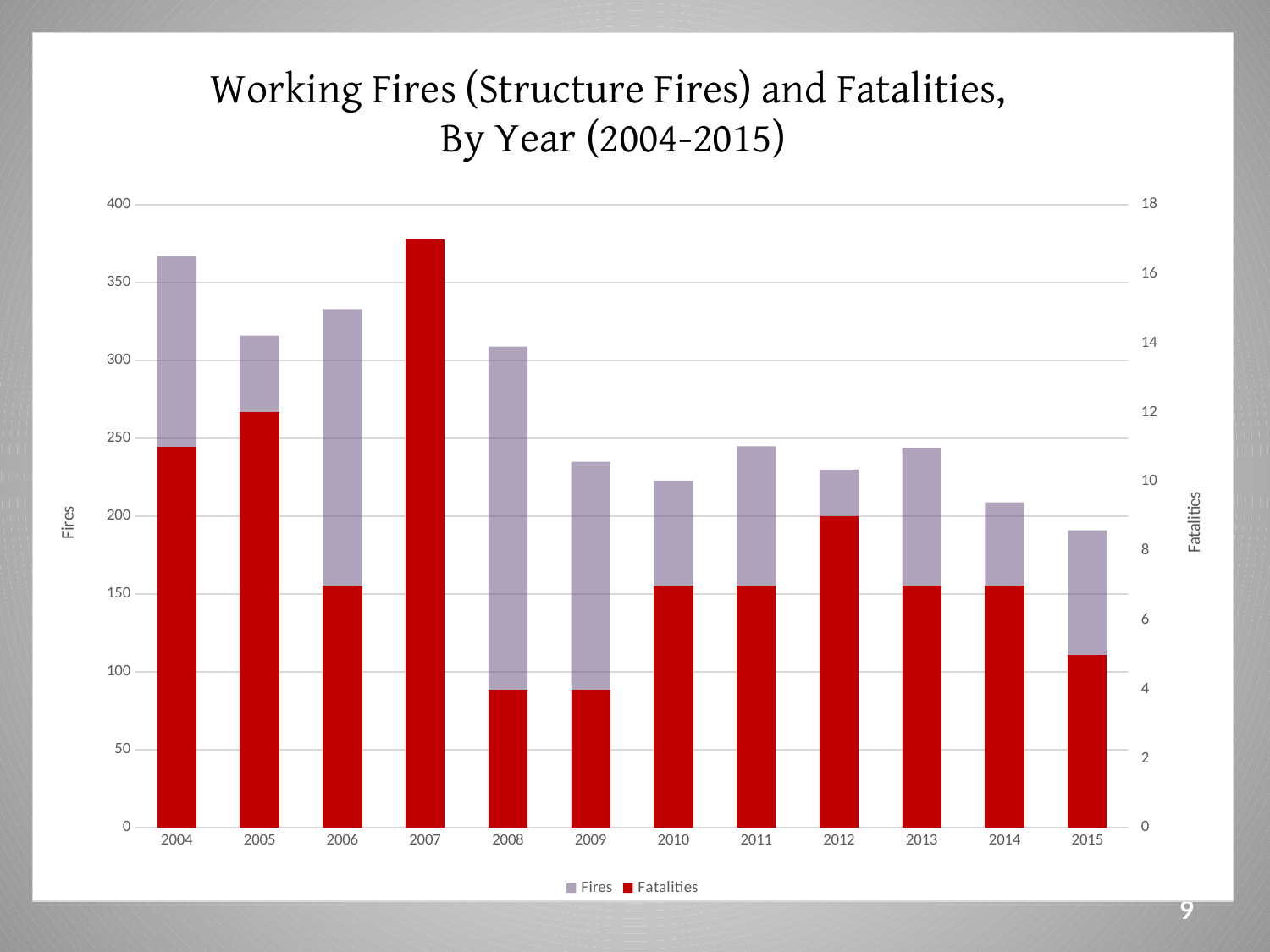
Which year had more fatalities, 2010 or 2012? 2012 What is the number of fatalities in 2005? 12 What kind of chart is shown on the slide? bar chart Is the number of fatalities in 2007 greater or less than 16? greater Which year has the highest number of fatalities? 2007 How many series does the legend list? 2 What is the number of fatalities in 2008? 4 How many years are shown on the x axis of the chart? 12 Which colour represents the Fatalities series in the chart? red Is the number of fires in 2004 greater or less than 350? greater Which year has the lowest number of fires? 2015 Is the number of fires in 2015 greater or less than 200? less